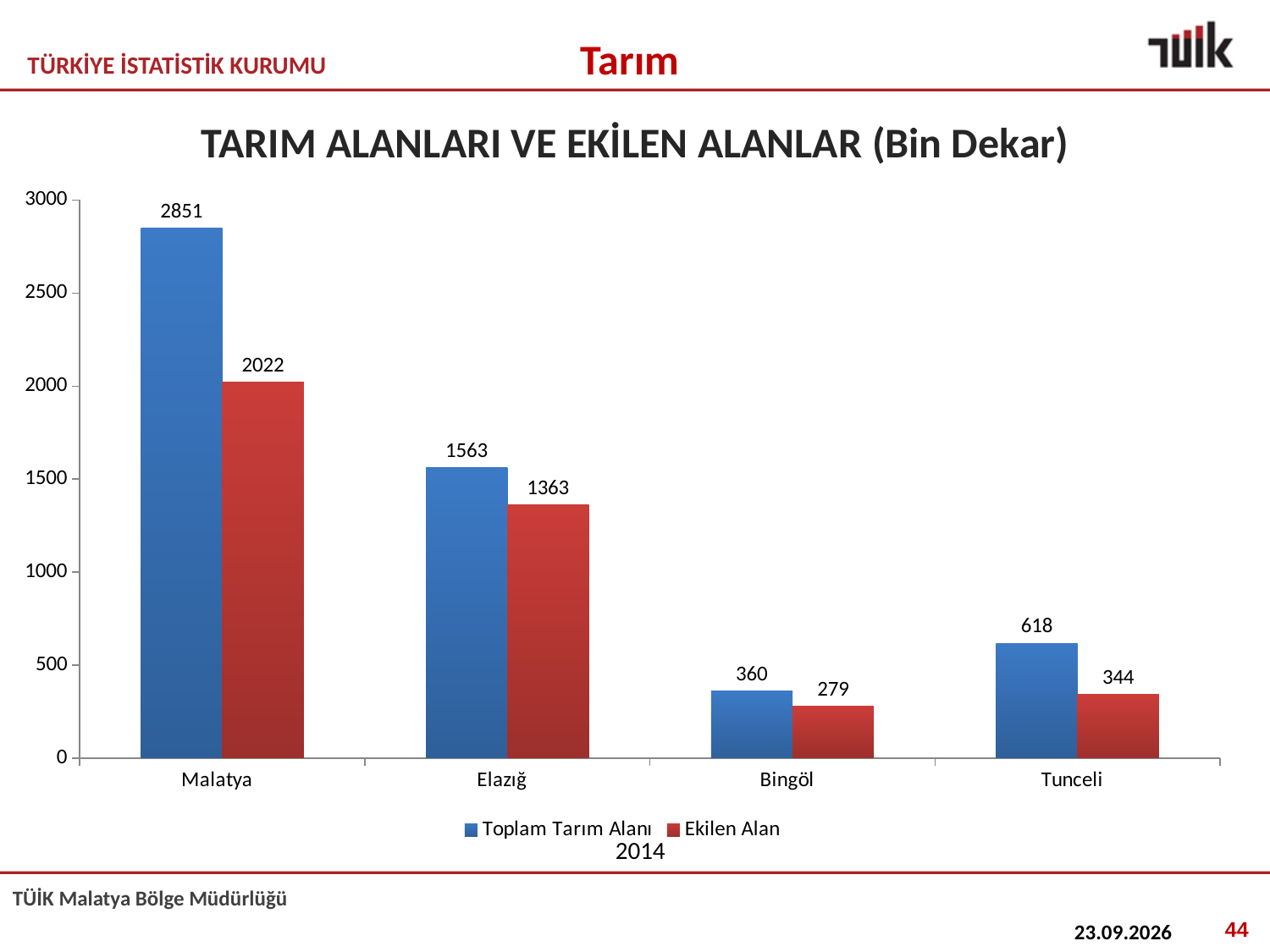
Which province has the highest Toplam Tarım Alanı? Malatya How many series does the legend list? 2 Which is larger: the Ekilen Alan for Elazığ or the Toplam Tarım Alanı for Tunceli? Ekilen Alan for Elazığ What is the title of the chart? TARIM ALANLARI VE EKİLEN ALANLAR (Bin Dekar) What is the Ekilen Alan value for Tunceli? 344 What kind of chart is shown on the slide? Bar chart What is the difference between the Toplam Tarım Alanı values of Tunceli and Bingöl? 258 What is the difference between Toplam Tarım Alanı and Ekilen Alan for Malatya? 829 Which province has the lowest Ekilen Alan? Bingöl What is the Toplam Tarım Alanı value for Malatya? 2851 What is the Ekilen Alan value for Elazığ? 1363 How many provinces are shown on the x axis? 4